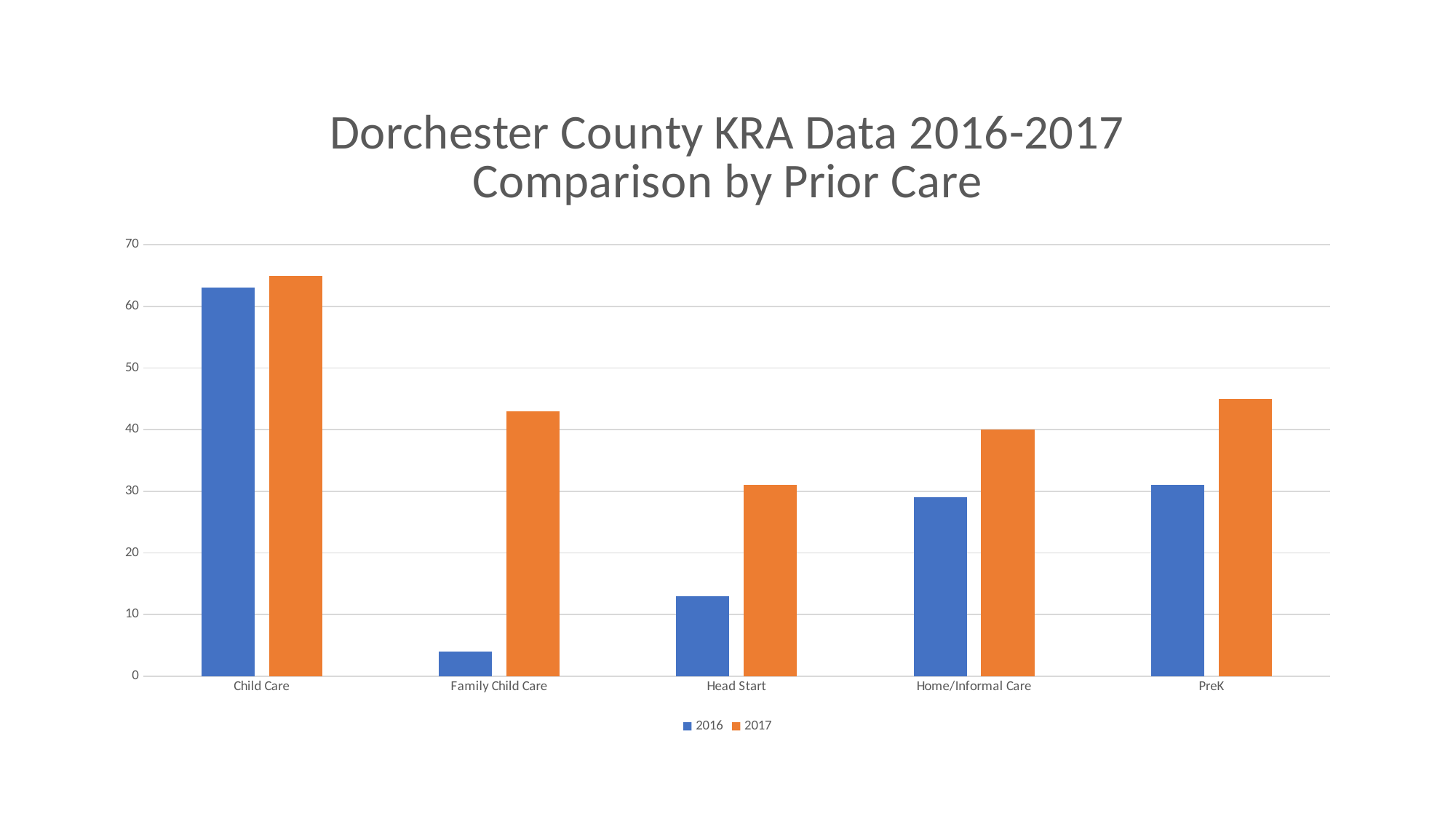
Which category has the highest 2017 value? Child Care Which is larger for Head Start, the 2016 value or the 2017 value? 2017 Is the 2017 value for Child Care greater or less than 60? greater How many prior care categories are shown on the x axis? 5 Which is larger, the 2017 value for Family Child Care or the 2017 value for Head Start? Family Child Care Which category has the lowest 2016 value? Family Child Care What is the title of the chart? Dorchester County KRA Data 2016-2017 Comparison by Prior Care Is the 2016 value for Family Child Care greater or less than 10? less How many series does the legend list? 2 What kind of chart is shown on the slide? bar chart Is the 2016 value for Head Start greater or less than 20? less